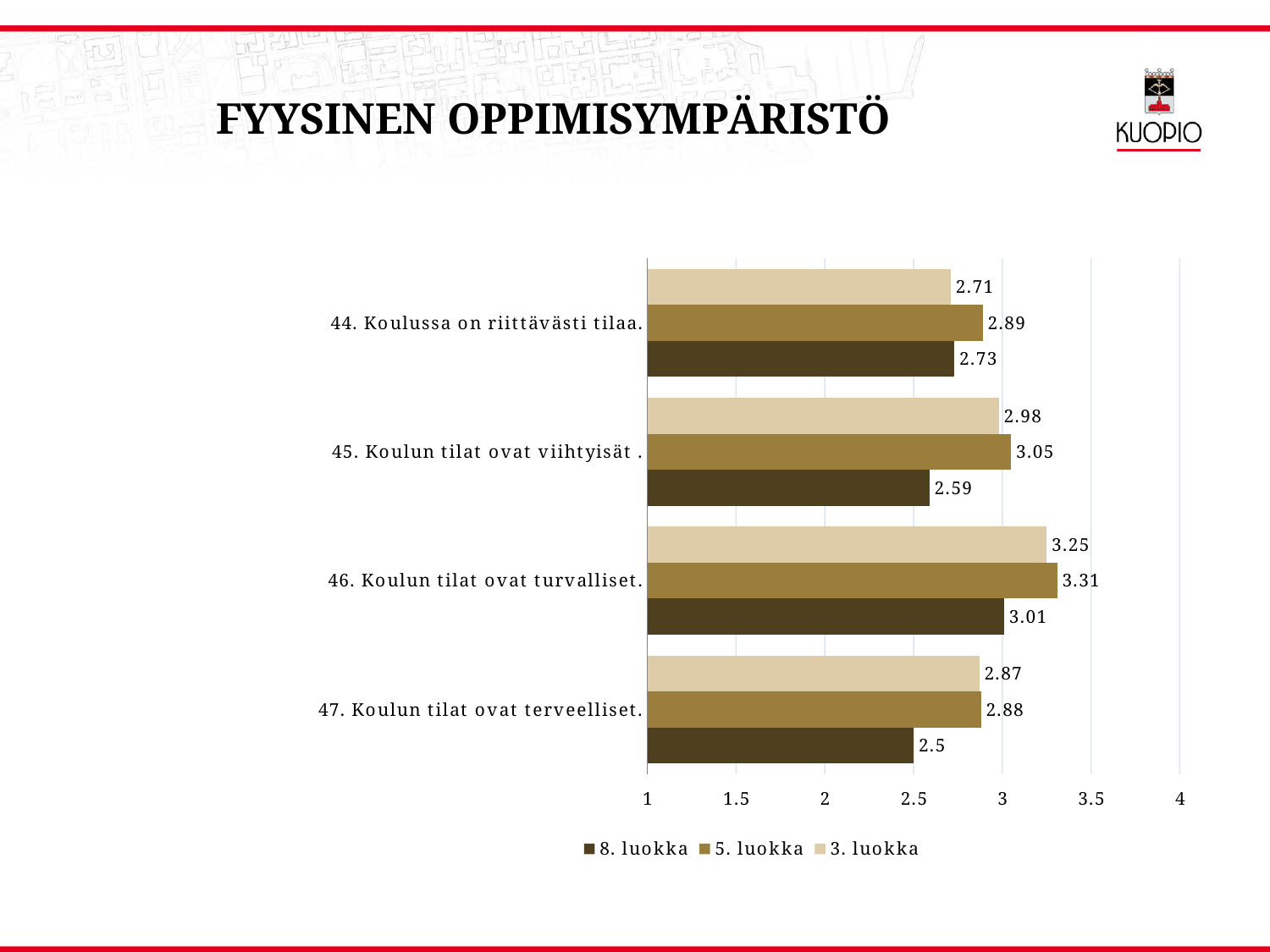
What is the value for 3. luokka for "45. Koulun tilat ovat viihtyisät ."? 2.98 What is the difference between the 5. luokka and 8. luokka values for "45. Koulun tilat ovat viihtyisät ."? 0.46 Which statement has the lowest value for 3. luokka? 44. Koulussa on riittävästi tilaa. What is the value for 8. luokka for "47. Koulun tilat ovat terveelliset."? 2.5 How many categories (statements) are shown on the chart? 4 Which statement has the highest value for 8. luokka? 46. Koulun tilat ovat turvalliset. For "44. Koulussa on riittävästi tilaa.", which is larger: the 5. luokka value or the 3. luokka value? 5. luokka What is the value for 5. luokka for "46. Koulun tilat ovat turvalliset."? 3.31 Is the 8. luokka value for "46. Koulun tilat ovat turvalliset." greater or less than 3? greater How many series does the legend list? 3 What kind of chart is shown on the slide? bar chart Which series is shown with the darkest bars in the legend? 8. luokka